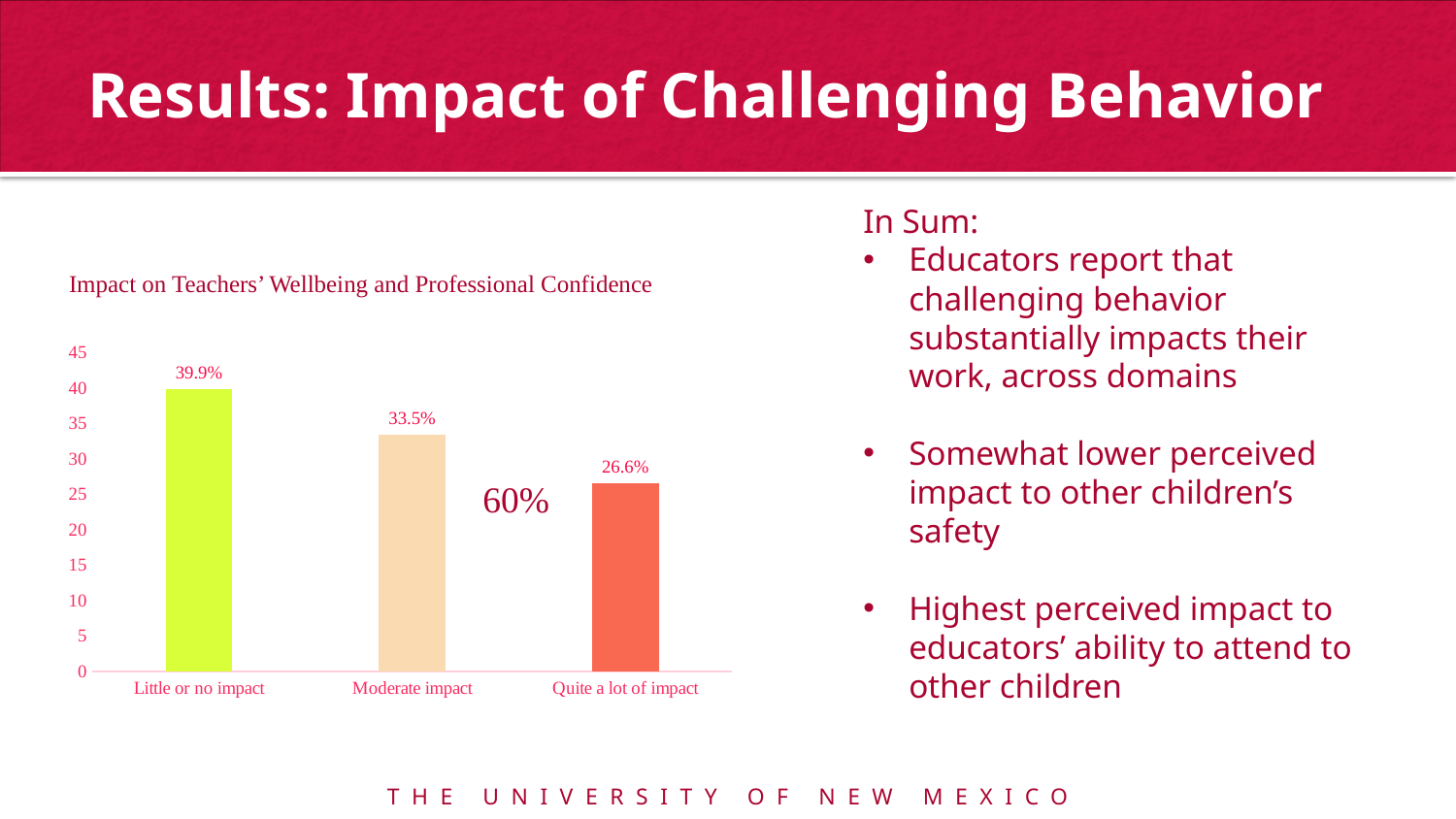
Which category has the highest value? Little or no impact What is the value for "Little or no impact"? 39.9% What is the value for "Quite a lot of impact"? 26.6% Which category has the lowest value? Quite a lot of impact What kind of chart is shown on the slide? Bar chart What is the value for "Moderate impact"? 33.5% What is the title of the chart? Impact on Teachers' Wellbeing and Professional Confidence How many categories are shown on the x axis? 3 Is the value for "Little or no impact" greater or less than 35? greater Which is larger, the value for "Moderate impact" or the value for "Quite a lot of impact"? Moderate impact What is the difference between the values for "Little or no impact" and "Quite a lot of impact"? 13.3% What is the difference between the values for "Moderate impact" and "Quite a lot of impact"? 6.9%